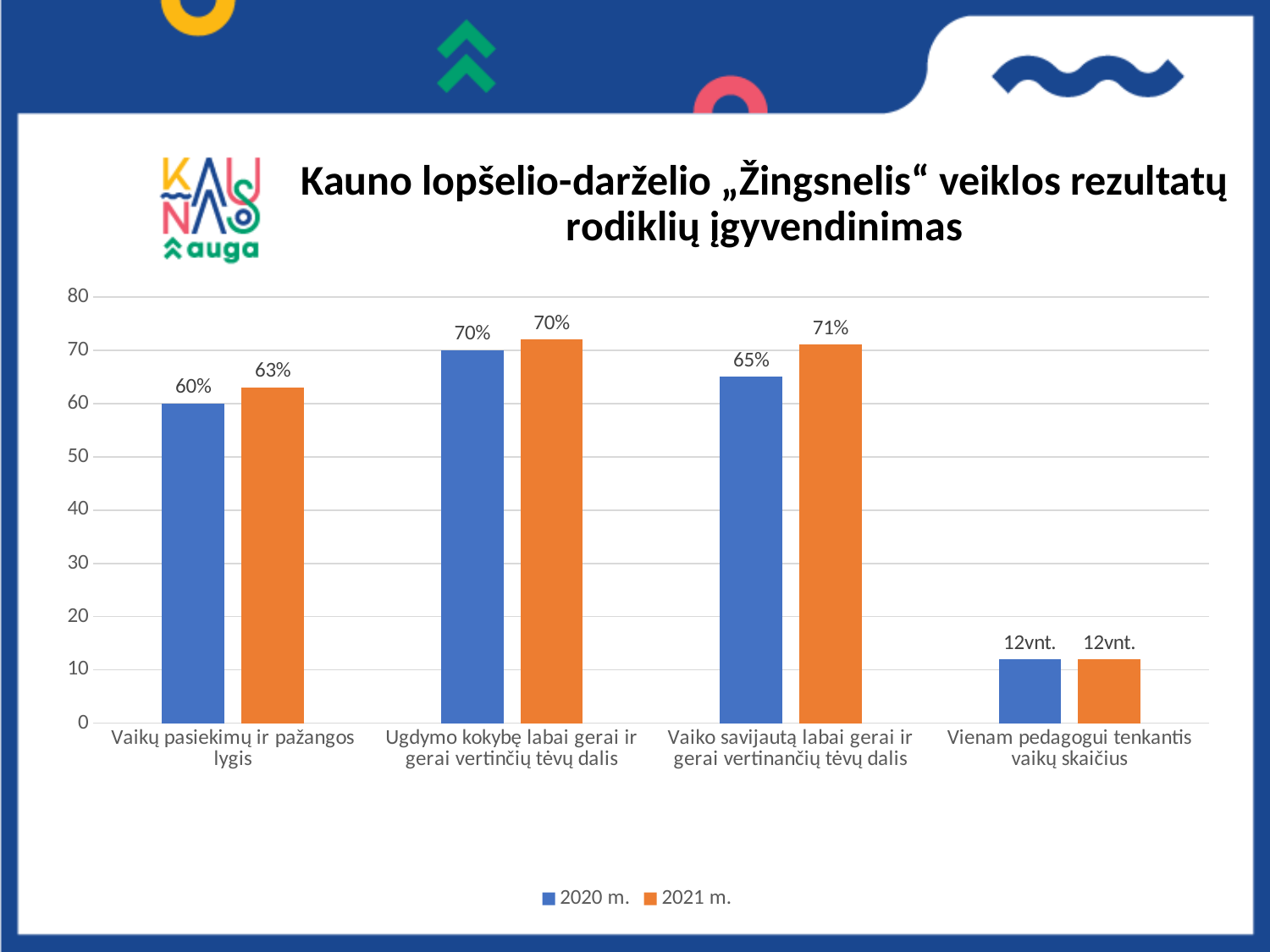
What is the 2021 m. value for "Vaikų pasiekimų ir pažangos lygis"? 63% What kind of chart is shown on the slide? Bar chart What is the 2020 m. value for "Vienam pedagogui tenkantis vaikų skaičius"? 12vnt. Which category has the lowest 2021 m. value? Vienam pedagogui tenkantis vaikų skaičius What is the 2020 m. value for "Vaikų pasiekimų ir pažangos lygis"? 60% Which is larger for "Vaikų pasiekimų ir pažangos lygis": the 2020 m. value or the 2021 m. value? 2021 m. What is the 2021 m. value for "Vaiko savijautą labai gerai ir gerai vertinančių tėvų dalis"? 71% Which colour represents the 2021 m. series? Orange How many series does the legend list? 2 What is the difference between the 2021 m. and 2020 m. values for "Vaiko savijautą labai gerai ir gerai vertinančių tėvų dalis"? 6% How many categories are shown on the x axis? 4